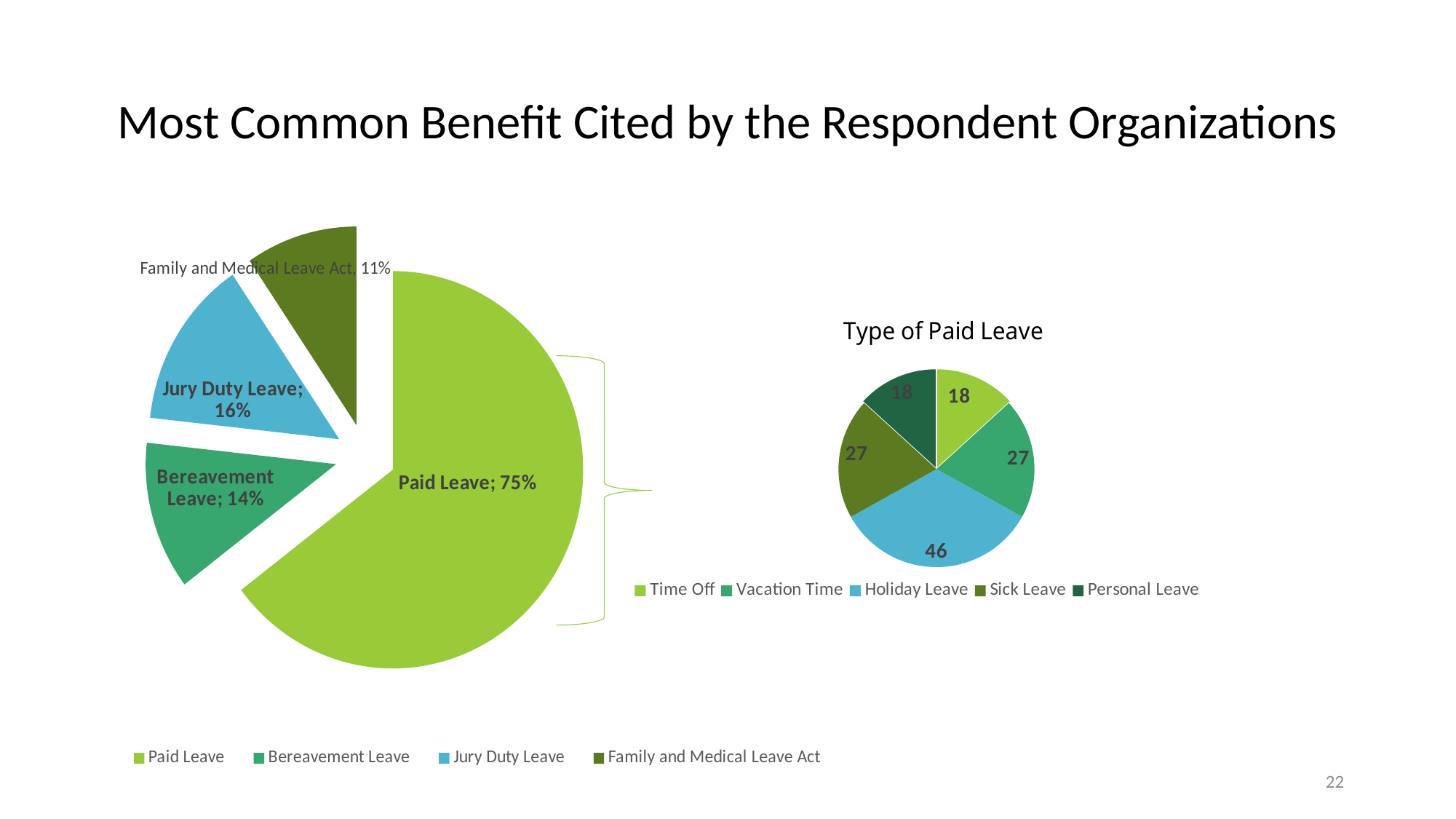
In the 'Type of Paid Leave' chart, what is the value for Sick Leave? 27 In the 'Type of Paid Leave' chart, what is the value for Holiday Leave? 46 In the large pie chart on the left, what percentage is shown for Jury Duty Leave? 16% What kind of chart is the 'Type of Paid Leave' chart? Pie chart In the large pie chart on the left, how many categories does the legend list? 4 In the large pie chart on the left, what percentage is shown for Paid Leave? 75% In the 'Type of Paid Leave' chart, what is the difference between the values for Holiday Leave and Time Off? 28 In the large pie chart on the left, what percentage is shown for Family and Medical Leave Act? 11% In the large pie chart on the left, what is the difference in percentage points between Paid Leave and Jury Duty Leave? 59 In the large pie chart on the left, what percentage is shown for Bereavement Leave? 14% In the 'Type of Paid Leave' chart, which type of paid leave has the largest slice? Holiday Leave In the large pie chart on the left, which benefit has the smallest slice? Family and Medical Leave Act